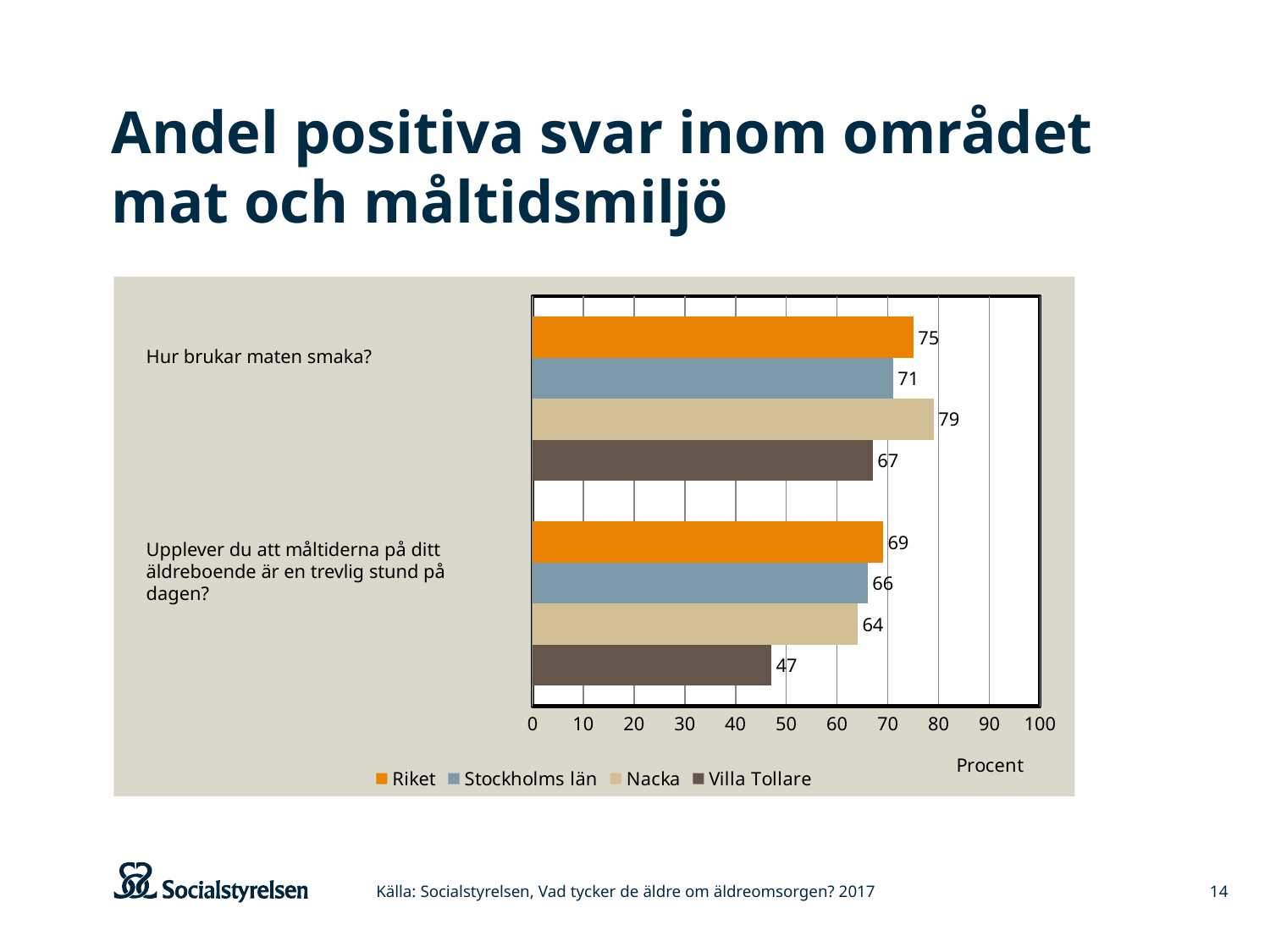
What is the value for Riket for "Hur brukar maten smaka?"? 75 Which series has the lowest value for "Upplever du att måltiderna på ditt äldreboende är en trevlig stund på dagen?"? Villa Tollare How many series does the legend list? 4 What is the value for Nacka for "Hur brukar maten smaka?"? 79 Which series has the highest value for "Hur brukar maten smaka?"? Nacka What is the value for Villa Tollare for "Upplever du att måltiderna på ditt äldreboende är en trevlig stund på dagen?"? 47 What kind of chart is shown on the slide? Bar chart What is the difference between the Nacka and Villa Tollare values for "Hur brukar maten smaka?"? 12 What is the difference between the Riket and Villa Tollare values for "Upplever du att måltiderna på ditt äldreboende är en trevlig stund på dagen?"? 22 Which is larger: the Riket value for "Hur brukar maten smaka?" or the Riket value for "Upplever du att måltiderna på ditt äldreboende är en trevlig stund på dagen?"? Hur brukar maten smaka? What is the value for Stockholms län for "Upplever du att måltiderna på ditt äldreboende är en trevlig stund på dagen?"? 66 What unit label is shown on the x axis? Procent